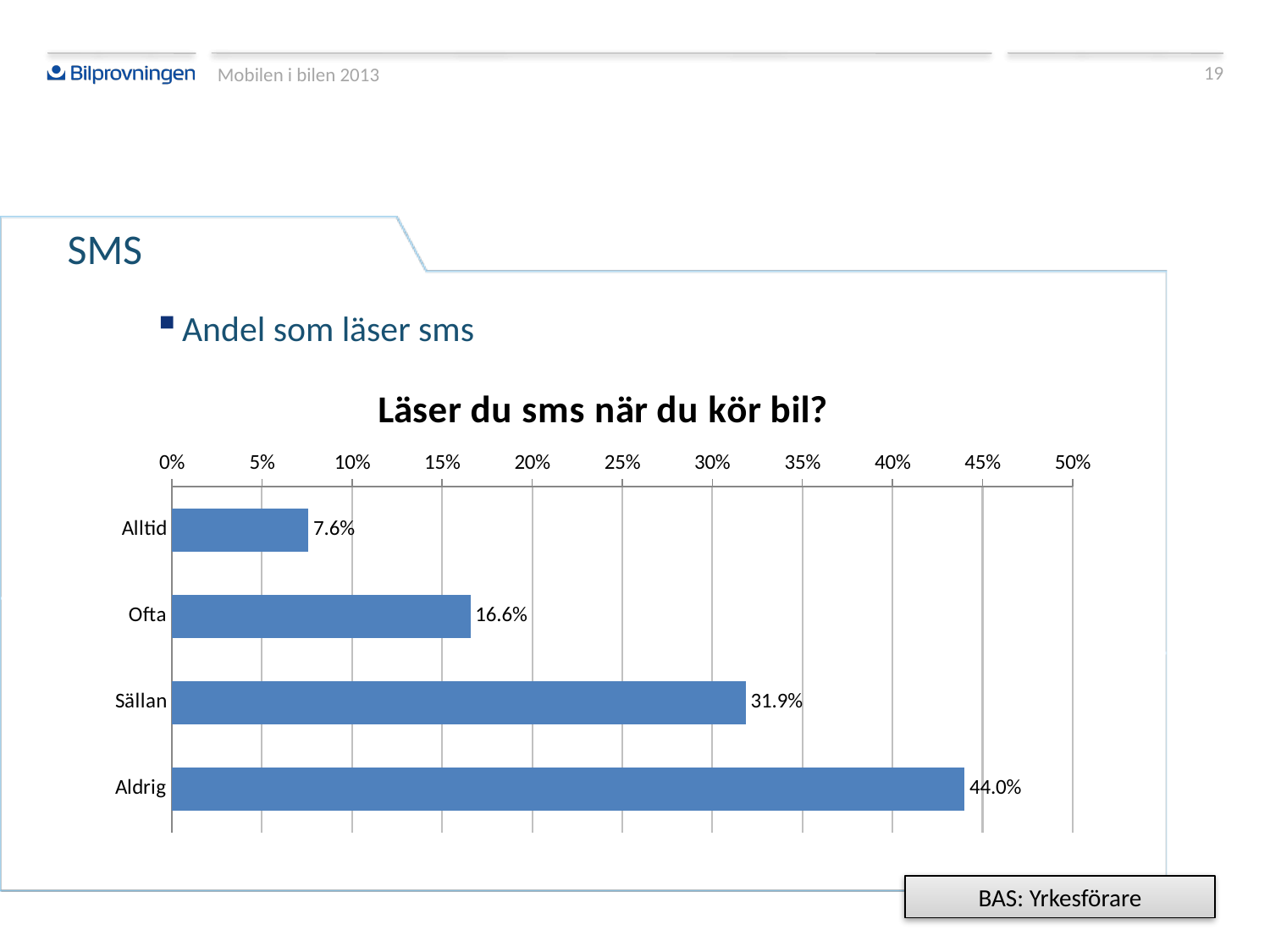
What is the value for Aldrig? 44.0% Is the value for Sällan greater or less than 30%? greater What is the value for Ofta? 16.6% How many categories are shown in the chart? 4 What is the value for Sällan? 31.9% Which category has the highest value? Aldrig What kind of chart is shown on the slide? Bar chart Which category has the lowest value? Alltid What is the difference between the values for Aldrig and Sällan? 12.1% What is the title of the chart? Läser du sms när du kör bil? Which is larger, the value for Ofta or the value for Sällan? Sällan What is the value for Alltid? 7.6%